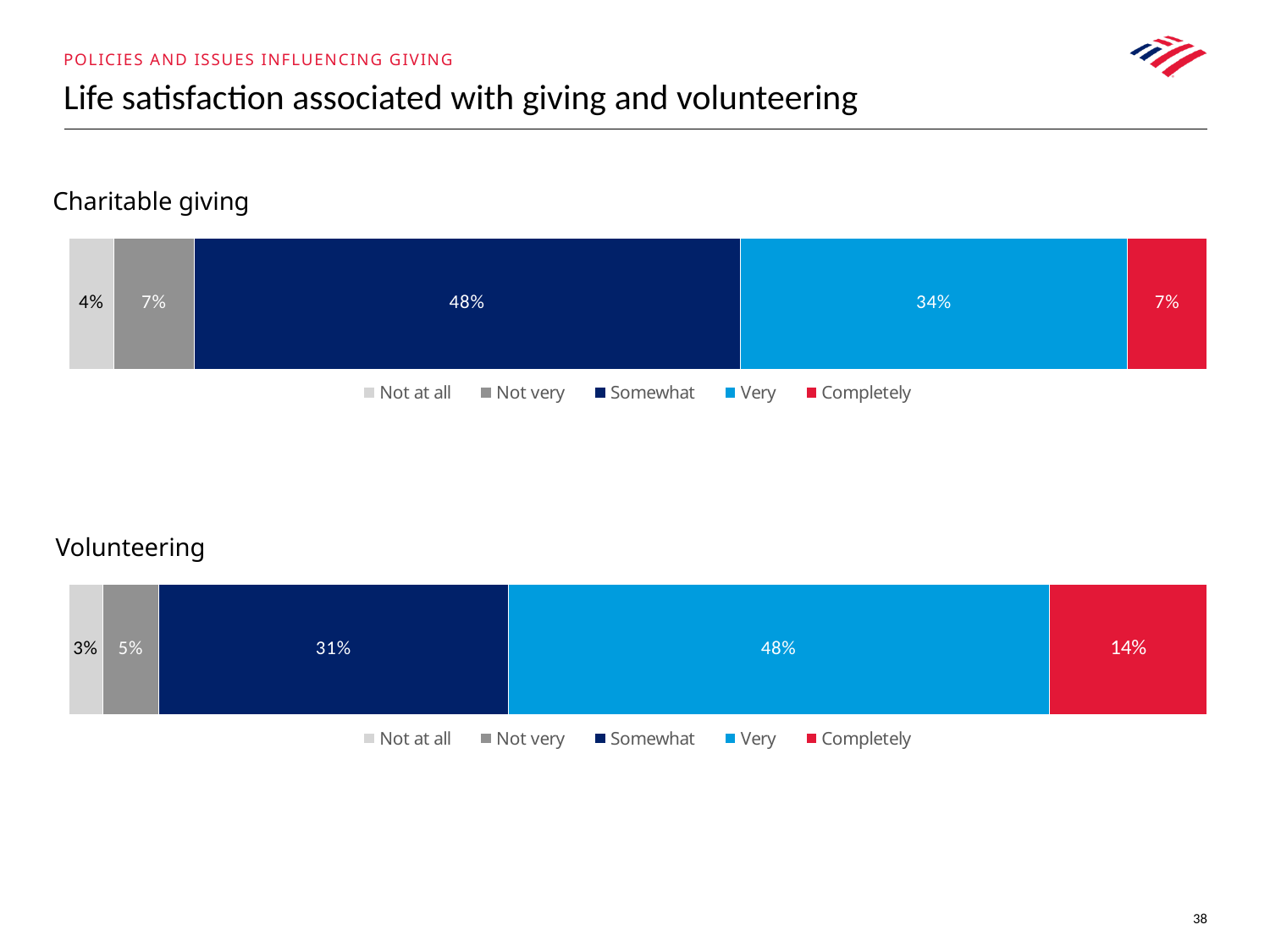
In the Volunteering chart, what percentage is shown for Not very? 5% In the Charitable giving chart, what percentage is shown for Very? 34% How many series does the legend of the Volunteering chart list? 5 In the Volunteering chart, what is the difference between the Very and Somewhat percentages? 17% In the Volunteering chart, what percentage is shown for Completely? 14% In the Volunteering chart, which category has the smallest share? Not at all In the Charitable giving chart, what percentage is shown for Somewhat? 48% What kind of chart is the Charitable giving chart? Stacked bar chart In the Charitable giving chart, which category has the largest share? Somewhat In the Charitable giving chart, which is larger: Somewhat or Very? Somewhat In the Charitable giving chart, what is the combined percentage of Very and Completely? 41% In the Volunteering chart, what colour is the Completely segment? Red